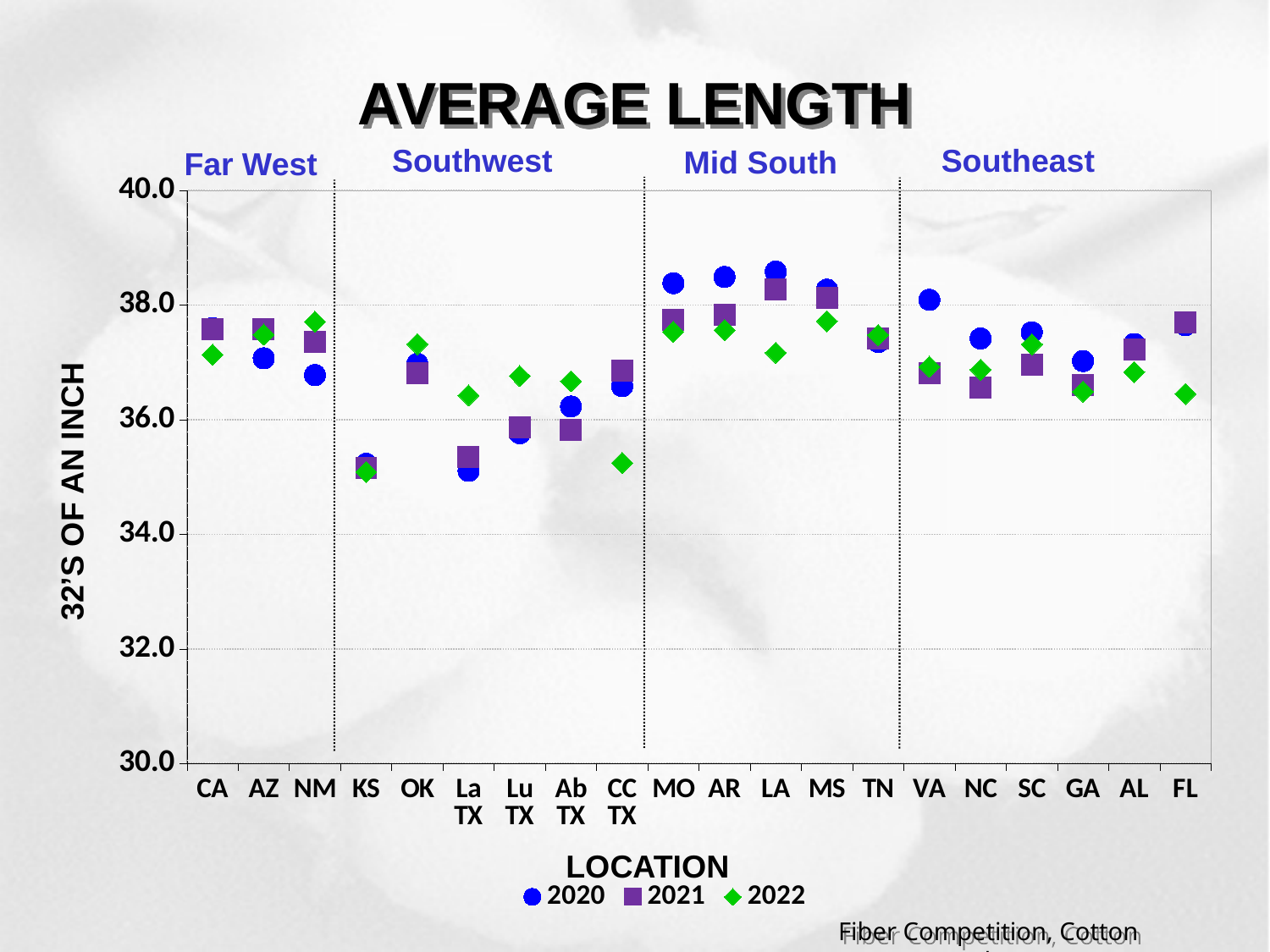
At VA, which year has the larger value, 2020 or 2021? 2020 What kind of chart is shown on the slide? Scatter (dot) plot How many series does the legend list? 3 Is the 2020 value for MO greater or less than 38.0? greater What is the y-axis title of the chart? 32'S OF AN INCH Is the 2022 value for FL greater or less than 37.0? less Is the 2022 value for CC TX greater or less than 36.0? less Which four regions are labelled across the top of the chart? Far West, Southwest, Mid South, Southeast At La TX, which year has the larger value, 2020 or 2022? 2022 How many locations are plotted along the x axis? 20